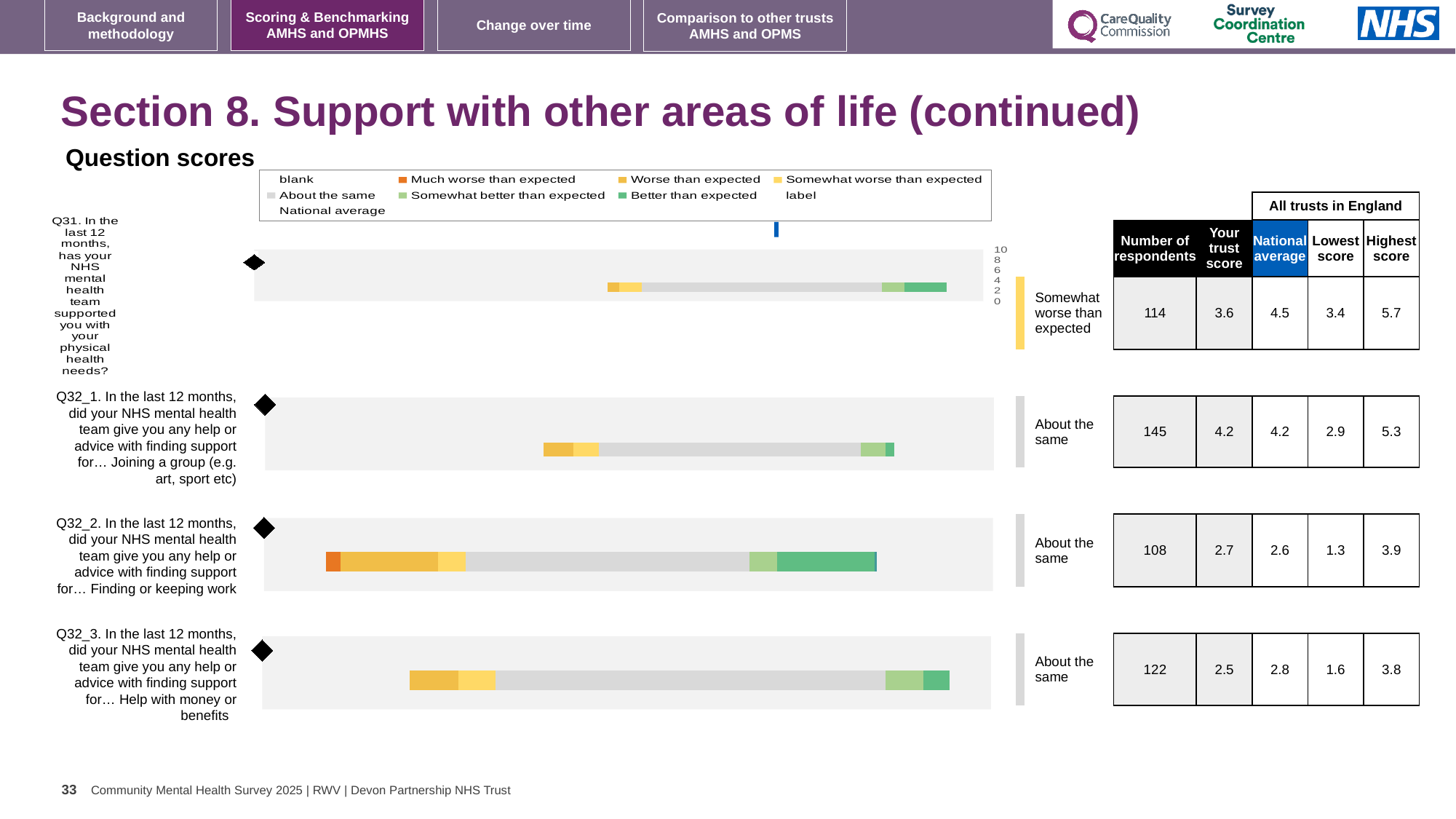
What is the 'Your trust score' value for Q31 (support with physical health needs)? 3.6 Which question has the lowest 'Your trust score'? Q32_3 (help with money or benefits) How many entries does the legend of the question scores chart list? 9 How many questions (bars) are plotted in the question scores chart? 4 For Q31, what is the difference between the highest score and the lowest score across all trusts in England? 2.3 What benchmark category label is shown next to the Q31 bar? Somewhat worse than expected How many respondents are recorded for Q32_2 (finding or keeping work)? 108 What is the national average for Q32_2 (finding or keeping work)? 2.6 Which question has the highest 'Your trust score'? Q32_1 (joining a group) What colour represents 'Better than expected' in the legend? green For Q32_3 (help with money or benefits), which is larger: the trust score or the national average? national average What kind of chart is used to show the question scores on this slide? bar chart